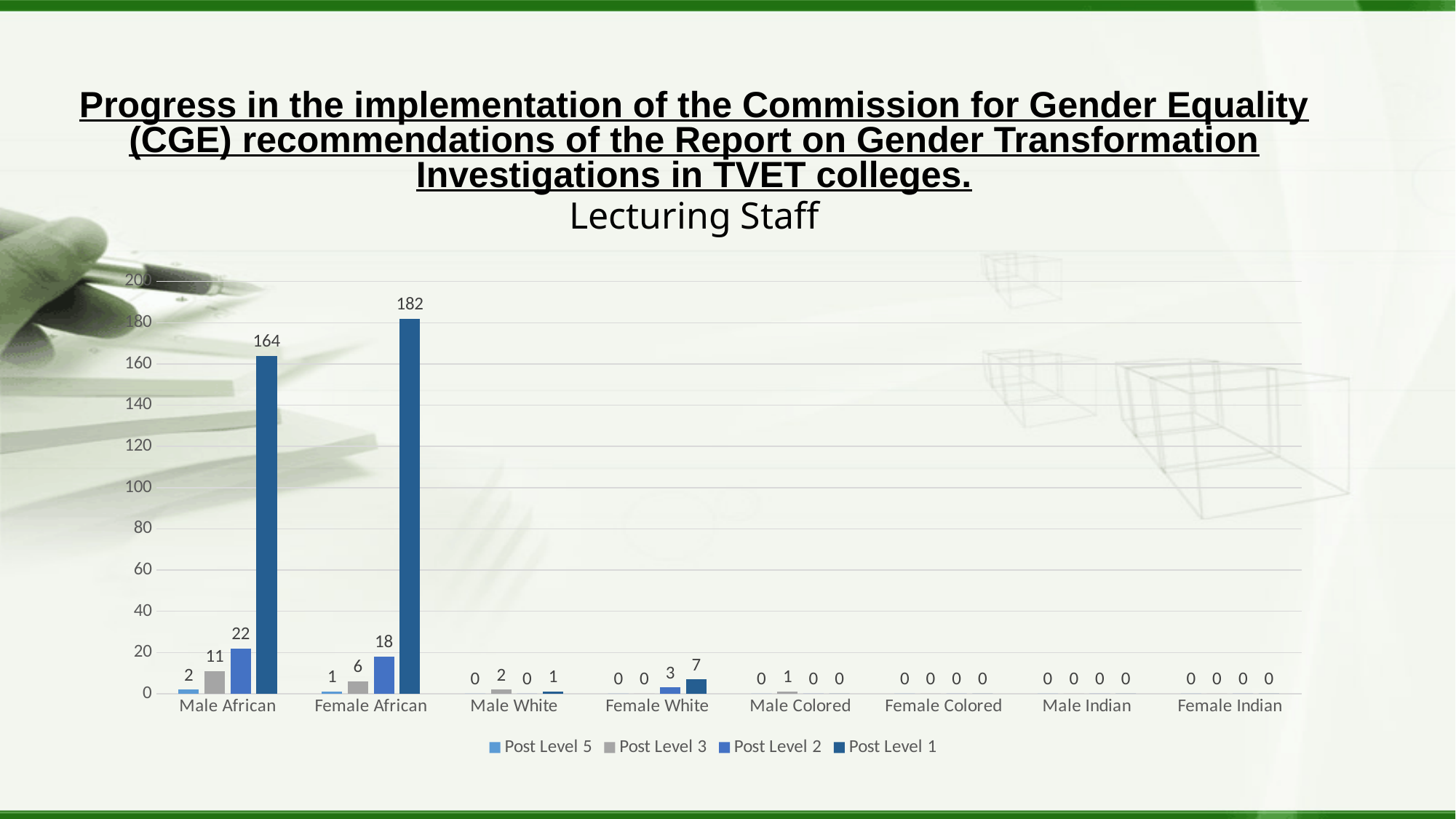
Which is larger, the Post Level 2 value for Male African or for Female African? Male African How many series does the legend list? 4 What is the difference between the Post Level 1 values for Female African and Male African? 18 What is the Post Level 2 value for Male African? 22 How many categories are shown on the x axis? 8 Is the Post Level 1 value for Male African greater or less than 140? greater What kind of chart is shown on the slide? Bar chart What is the Post Level 1 value for Female African? 182 What is the Post Level 1 value for Female White? 7 What is the Post Level 3 value for Female African? 6 Which category has the highest Post Level 1 value? Female African What is the title of the chart? Lecturing Staff